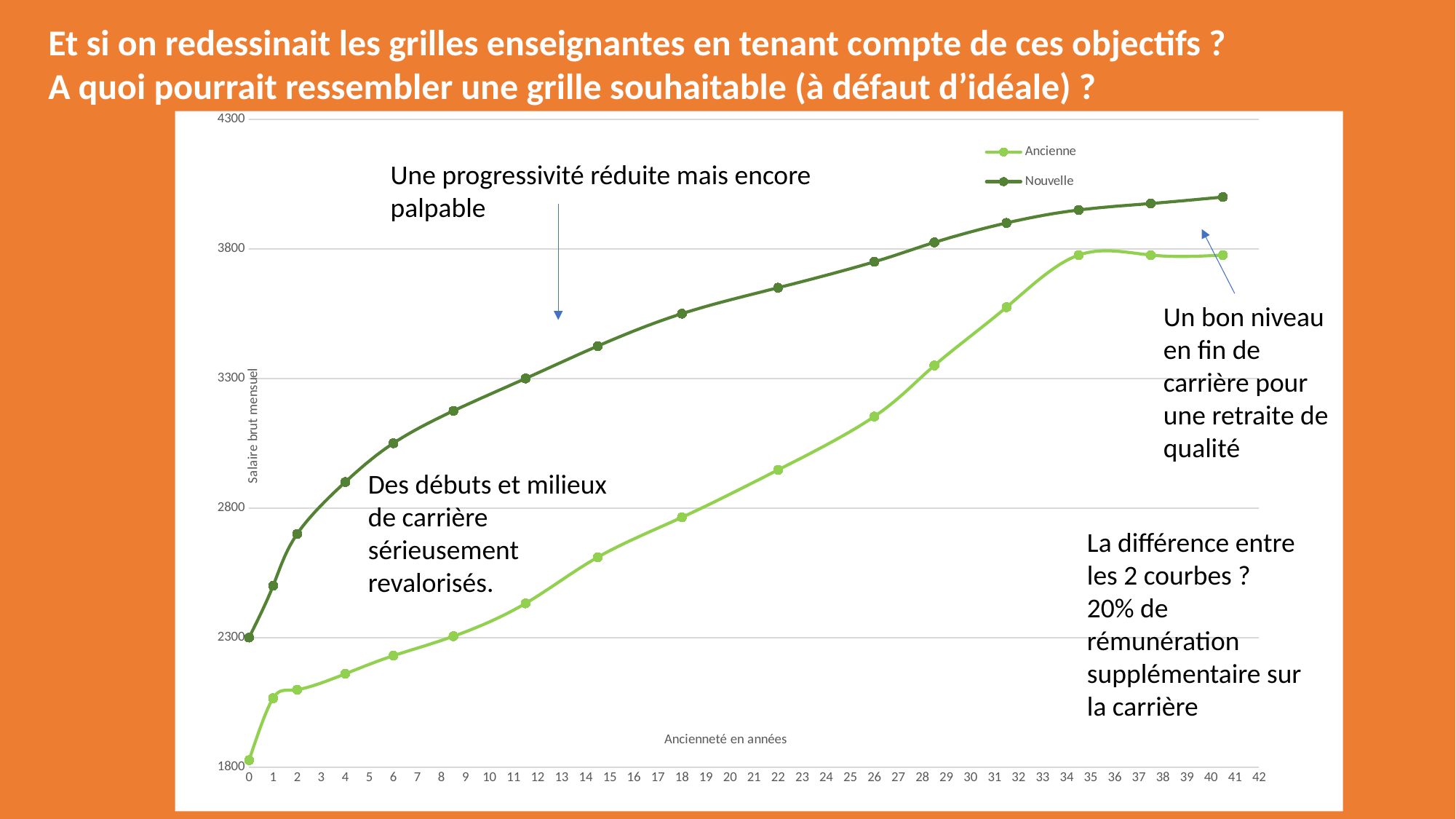
Does the Nouvelle series rise or fall as seniority increases along the x axis? rise What is the title of the vertical axis? Salaire brut mensuel At 26 years of seniority, which series has the higher value, Ancienne or Nouvelle? Nouvelle What are the two series named in the legend? Ancienne and Nouvelle At 0 years of seniority, which series has the higher value, Ancienne or Nouvelle? Nouvelle Is the value of the Ancienne series at 0 years greater or less than 2300? less What kind of chart is shown on the slide? line chart Is the value of the Nouvelle series at 18 years greater or less than 3300? greater How many series does the legend list? 2 Is the value of the Ancienne series at 22 years greater or less than 2800? greater What is the value of the Nouvelle series at 0 years of seniority? 2300